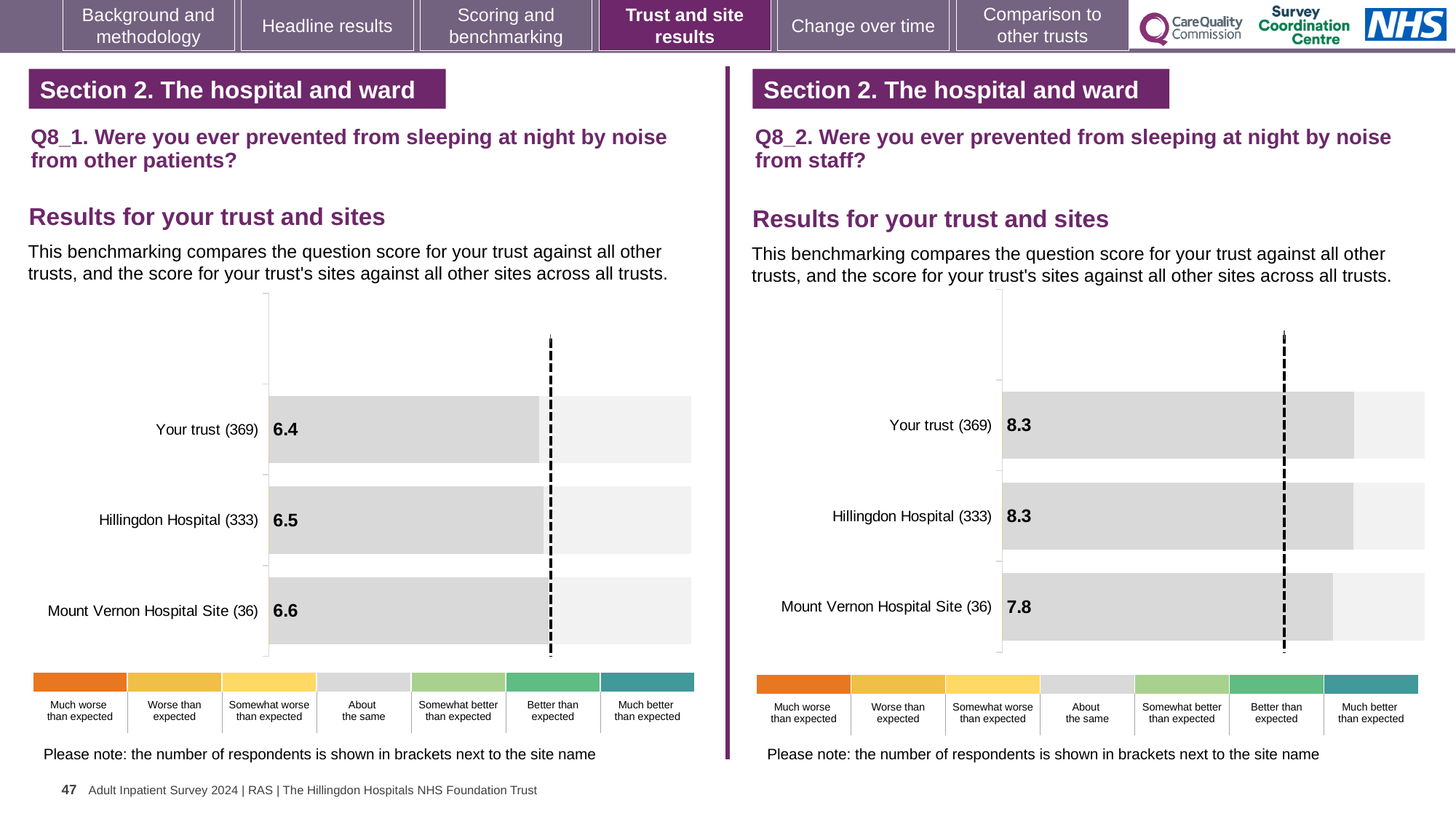
On the Q8_1 chart (left), what is the score for Your trust (369)? 6.4 On the Q8_1 chart (left), which site or trust has the highest score? Mount Vernon Hospital Site (36) What type of chart is used on the Q8_1 chart (left)? Bar chart How many bars are plotted on the Q8_2 chart (right)? 3 On the Q8_2 chart (right), what is the score for Hillingdon Hospital (333)? 8.3 On the Q8_1 chart (left), what is the difference between the scores for Mount Vernon Hospital Site (36) and Your trust (369)? 0.2 On the Q8_2 chart (right), what is the score for Mount Vernon Hospital Site (36)? 7.8 On the Q8_1 chart (left), which has the larger score, Hillingdon Hospital (333) or Your trust (369)? Hillingdon Hospital (333) On the Q8_2 chart (right), which site or trust has the lowest score? Mount Vernon Hospital Site (36) On the Q8_2 chart (right), what is the difference between the scores for Your trust (369) and Mount Vernon Hospital Site (36)? 0.5 On the Q8_1 chart (left), what is the score for Mount Vernon Hospital Site (36)? 6.6 How many respondents are shown in brackets for Hillingdon Hospital on the Q8_1 chart (left)? 333